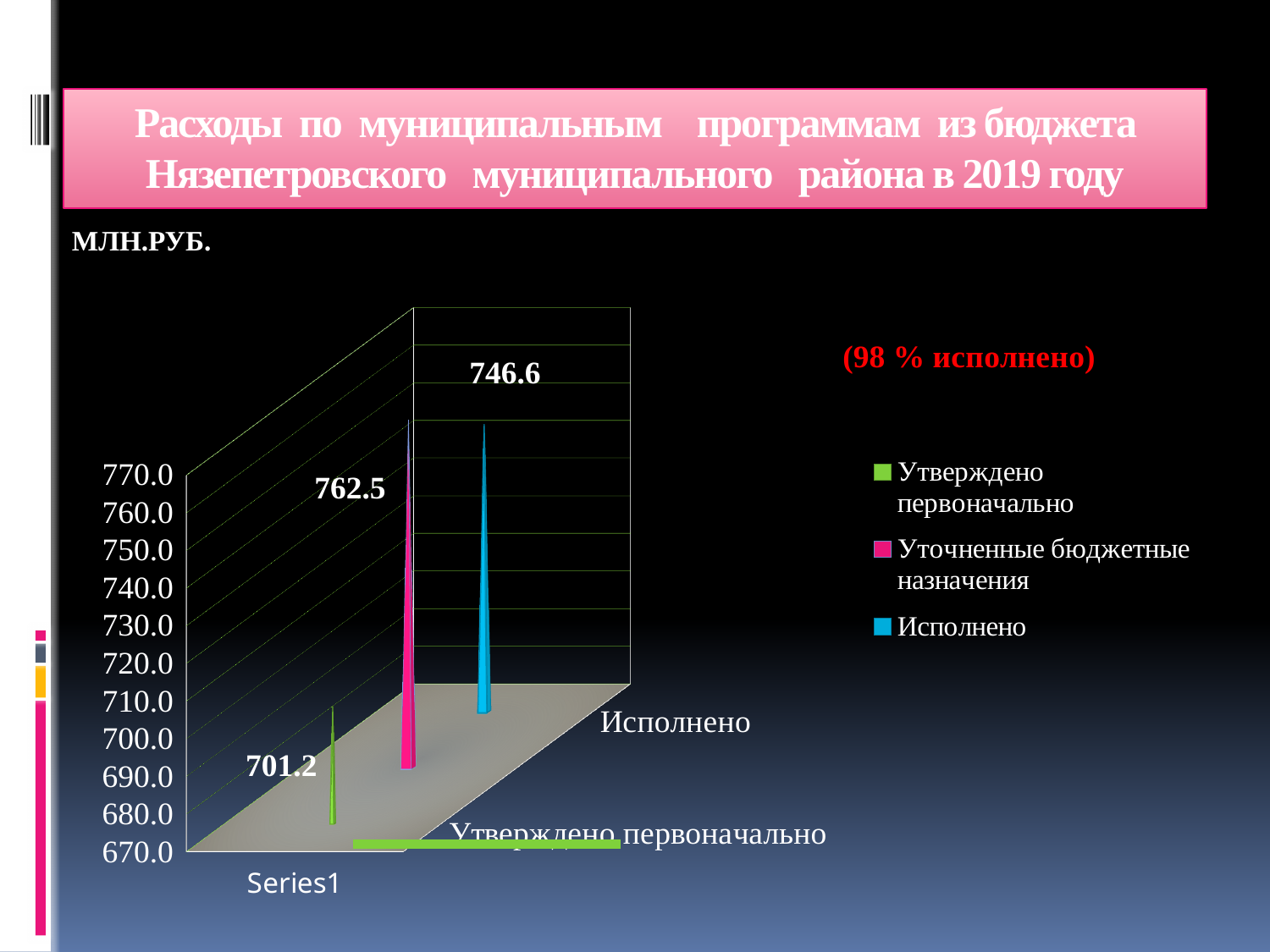
What kind of chart is shown on the slide? bar chart Which is larger, «Исполнено» or «Утверждено первоначально»? Исполнено What percentage of execution is stated in red text on the slide? 98 % What is the difference between «Исполнено» and «Утверждено первоначально»? 45.4 Is the value for «Утверждено первоначально» greater or less than 710.0? less Which series has the highest value? Уточненные бюджетные назначения Which series has the lowest value? Утверждено первоначально What is the value for «Утверждено первоначально»? 701.2 How many series does the legend list? 3 What is the value for «Исполнено»? 746.6 What is the difference between «Уточненные бюджетные назначения» and «Исполнено»? 15.9 What is the value for «Уточненные бюджетные назначения»? 762.5